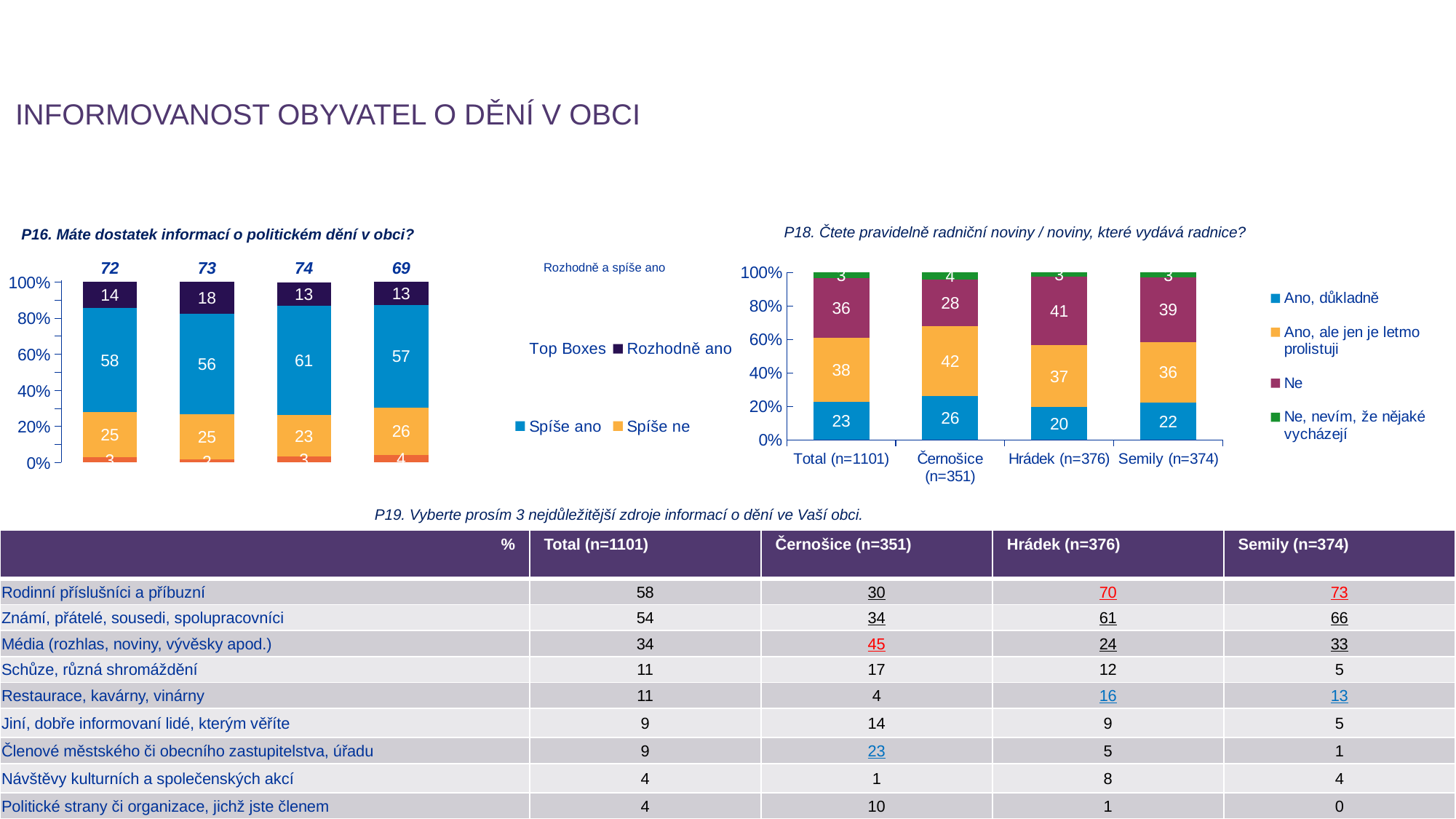
How many categories are shown on the x axis of the P18 chart? 4 In the P18 chart, is the 'Ano, ale jen je letmo prolistuji' value larger for Černošice (n=351) or for Semily (n=374)? Černošice (n=351) What kind of chart is the P18 chart? Stacked bar chart How many series does the legend of the P18 chart list? 4 In the P18 chart, what is the difference between the 'Ne' values for Hrádek (n=376) and Černošice (n=351)? 13 In the P18 chart, which category has the highest value for 'Ne'? Hrádek (n=376) In the P16 chart, what is the 'Top Boxes' value shown above the leftmost bar? 72 In the P18 chart, what is the value of 'Ano, důkladně' for Hrádek (n=376)? 20 In the P16 chart, what is the 'Spíše ano' value in the third bar from the left? 61 In the P18 chart, which category has the lowest value for 'Ano, důkladně'? Hrádek (n=376) In the P18 chart, what is the value of 'Ano, ale jen je letmo prolistuji' for Total (n=1101)? 38 In the P18 chart, what is the value of 'Ne' for Černošice (n=351)? 28